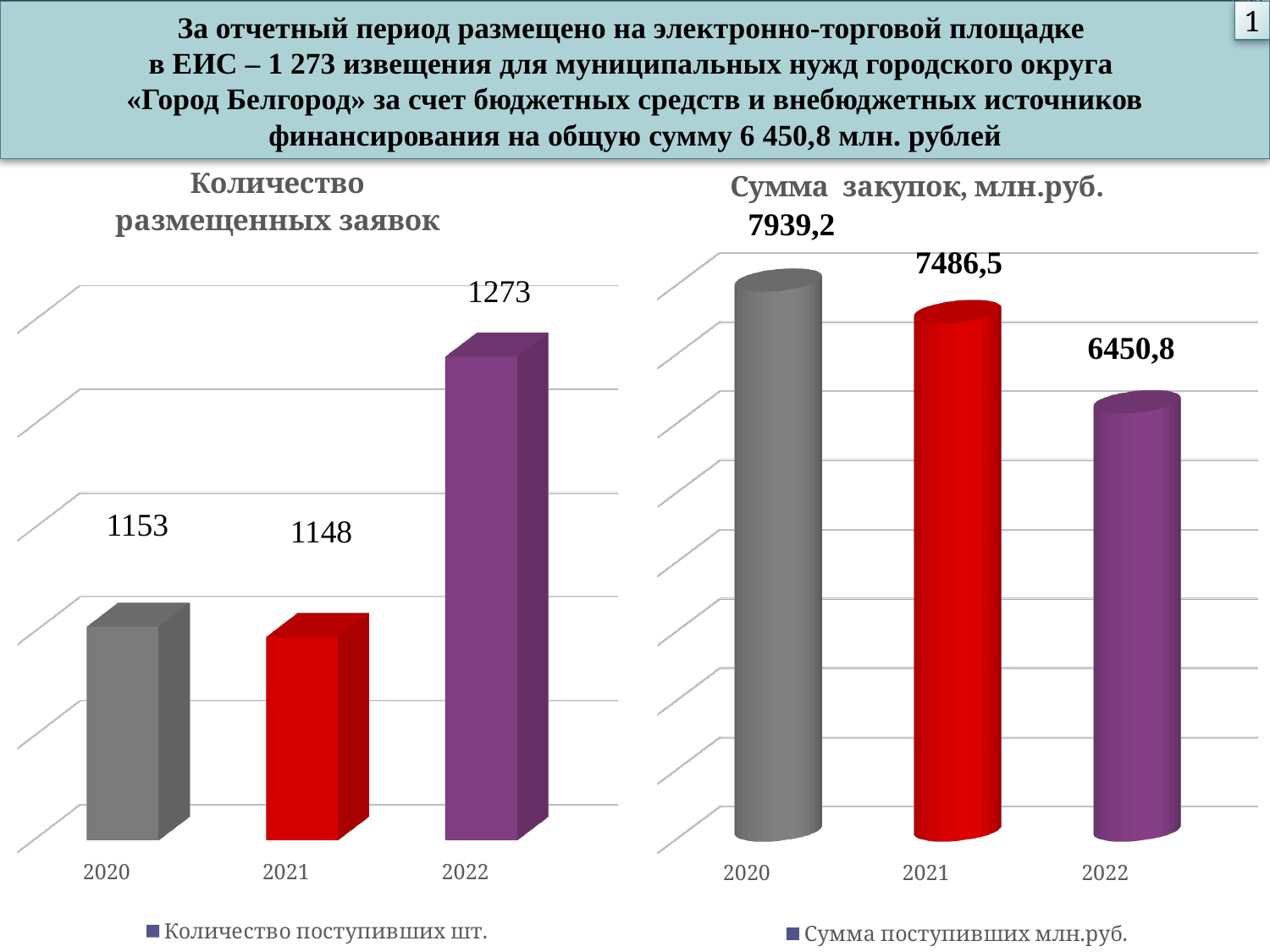
In the chart 'Количество размещенных заявок', what is the difference between the values for 2022 and 2021? 125 What kind of chart is the chart 'Сумма закупок, млн.руб.'? bar chart In the chart 'Сумма закупок, млн.руб.', which year has the lowest value? 2022 How many years are shown in the chart 'Количество размещенных заявок'? 3 In the chart 'Количество размещенных заявок', what is the value for 2022? 1273 In the chart 'Количество размещенных заявок', which year has the highest value? 2022 In the chart 'Сумма закупок, млн.руб.', do the values rise or fall from 2020 to 2022? fall In the chart 'Сумма закупок, млн.руб.', what is the value for 2022? 6450,8 In the chart 'Сумма закупок, млн.руб.', which year has the highest value? 2020 In the chart 'Количество размещенных заявок', what is the value for 2021? 1148 In the chart 'Сумма закупок, млн.руб.', what is the difference between the values for 2020 and 2021? 452,7 In the chart 'Сумма закупок, млн.руб.', what is the value for 2020? 7939,2